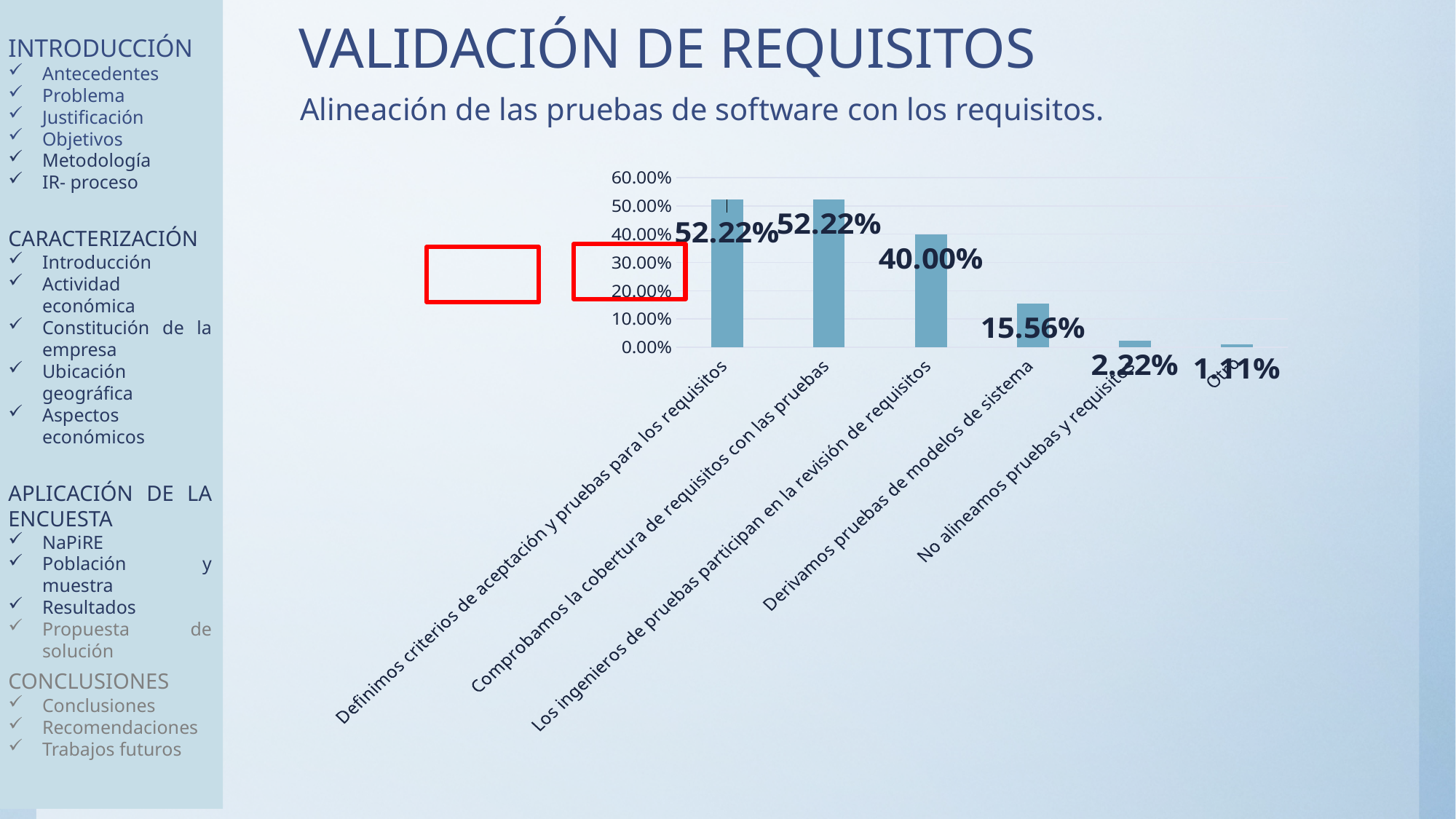
What is the value for 'Derivamos pruebas de modelos de sistema'? 15.56% What is the difference between the value for 'Los ingenieros de pruebas participan en la revisión de requisitos' and the value for 'Derivamos pruebas de modelos de sistema'? 24.44% Do the values rise or fall moving from left to right along the x axis? fall What is the value for 'Los ingenieros de pruebas participan en la revisión de requisitos'? 40.00% What is the value for 'Definimos criterios de aceptación y pruebas para los requisitos'? 52.22% Which is larger: the value for 'Los ingenieros de pruebas participan en la revisión de requisitos' or the value for 'Derivamos pruebas de modelos de sistema'? Los ingenieros de pruebas participan en la revisión de requisitos How many categories are plotted in the chart? 6 What type of chart is shown on the slide? bar chart What is the value for 'No alineamos pruebas y requisitos'? 2.22% What is the value for 'Comprobamos la cobertura de requisitos con las pruebas'? 52.22% Is the value for 'Derivamos pruebas de modelos de sistema' greater or less than 20.00%? less What is the subtitle text shown above the chart? Alineación de las pruebas de software con los requisitos.